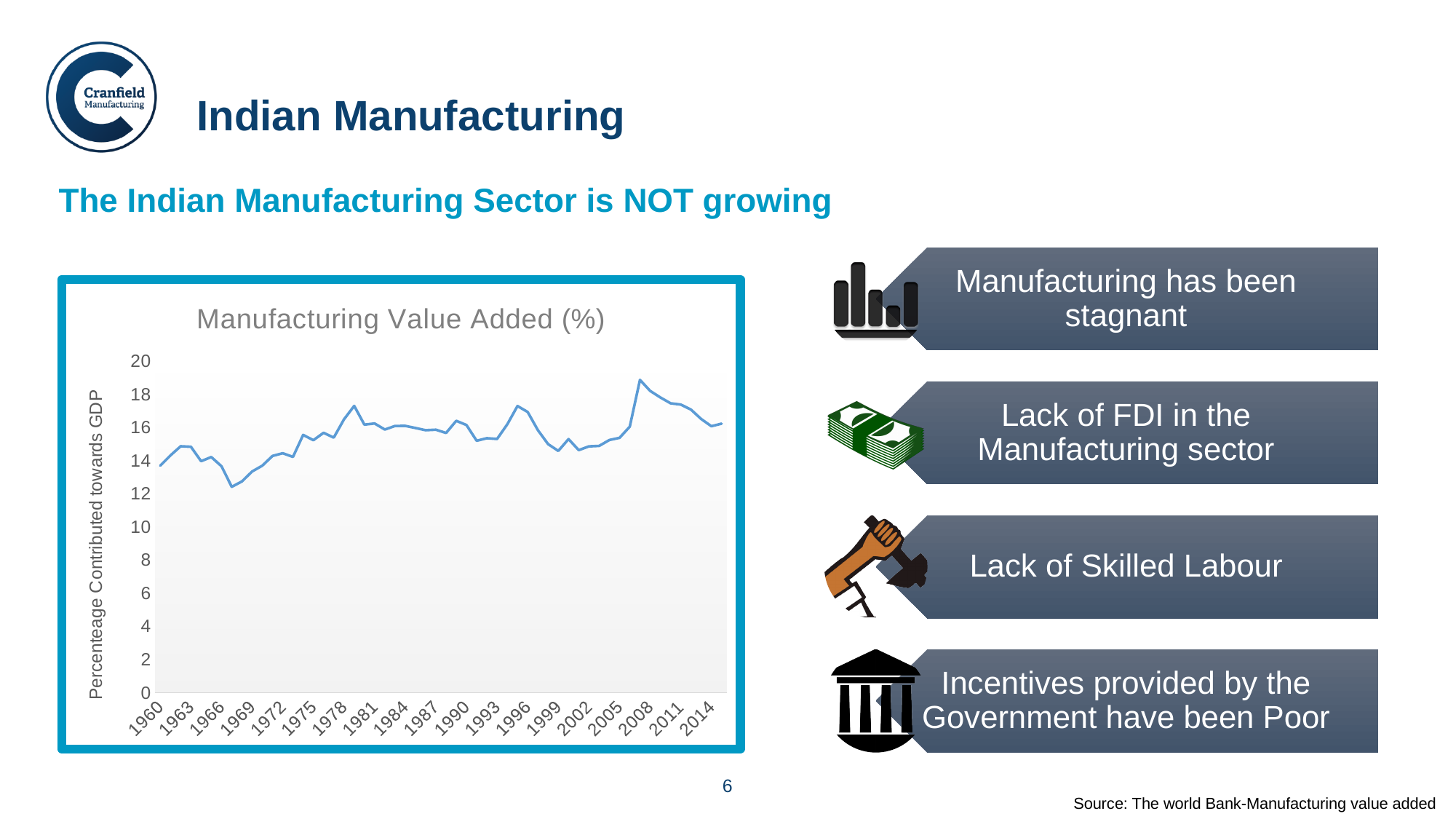
How many year labels are shown along the x axis of the chart? 19 Which year has the larger value, 1960 or 2008? 2008 Which year has the larger value, 1966 or 1978? 1978 What is the label on the vertical axis of the chart? Percenteage Contributed towards GDP What is the title of the chart? Manufacturing Value Added (%) Is the value for 1960 greater or less than 12? greater Do the values rise or fall between 2008 and 2014? fall What kind of chart is shown on the slide? line chart Is the value for 1978 greater or less than 16? greater Is the value for 2014 greater or less than 18? less